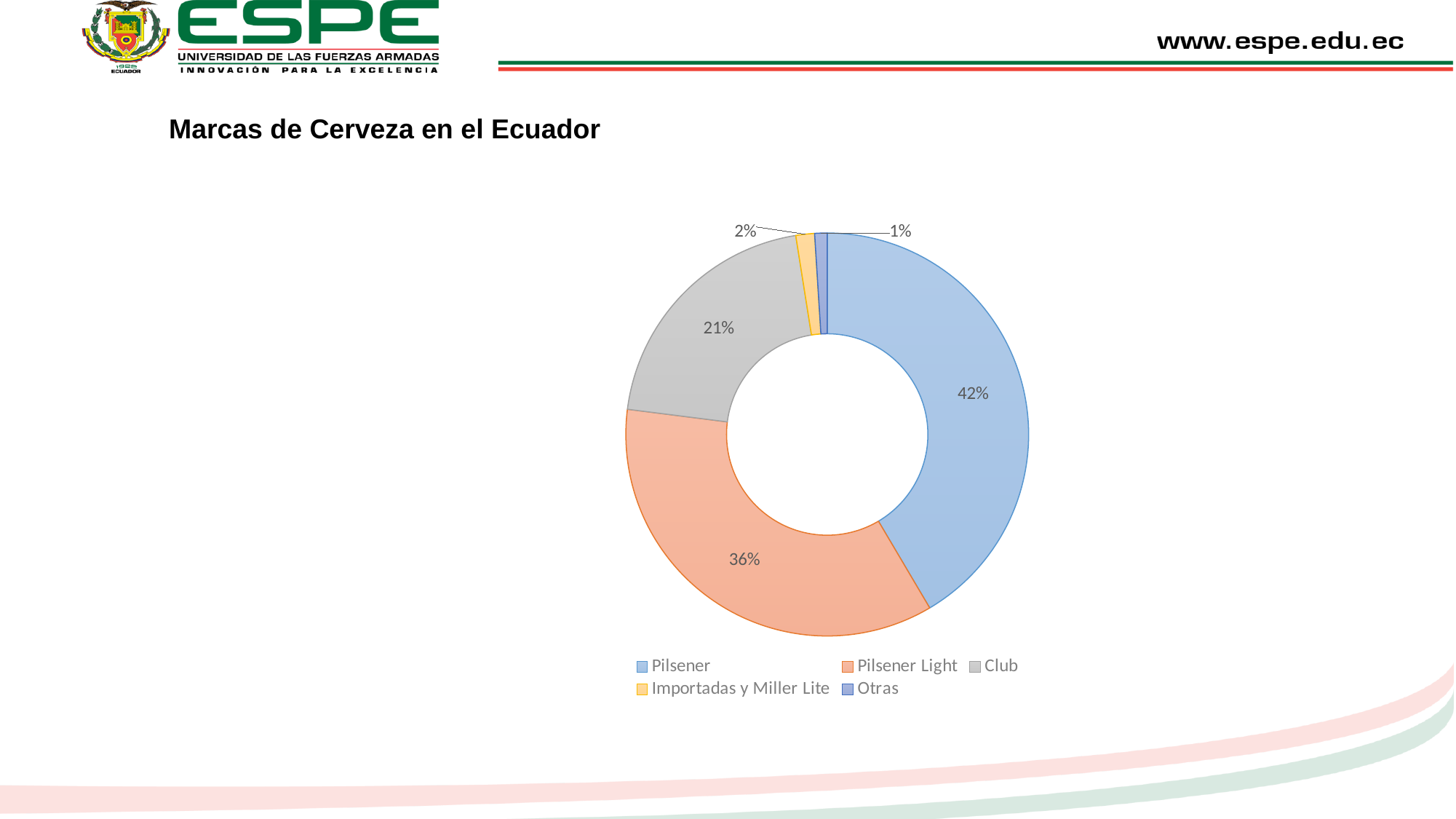
What share of the chart does Pilsener Light hold? 36% Which brand has the smallest share? Otras What kind of chart is shown on the slide? Doughnut (pie) chart What is the title of the slide above the chart? Marcas de Cerveza en el Ecuador What share of the chart does Otras hold? 1% What is the difference in percentage points between Pilsener and Pilsener Light? 6% Which brand has the largest share? Pilsener What share of the chart does Pilsener hold? 42% Which has a larger share, Club or Pilsener Light? Pilsener Light How many categories does the chart show? 5 What share of the chart does Club hold? 21% What share of the chart does Importadas y Miller Lite hold? 2%